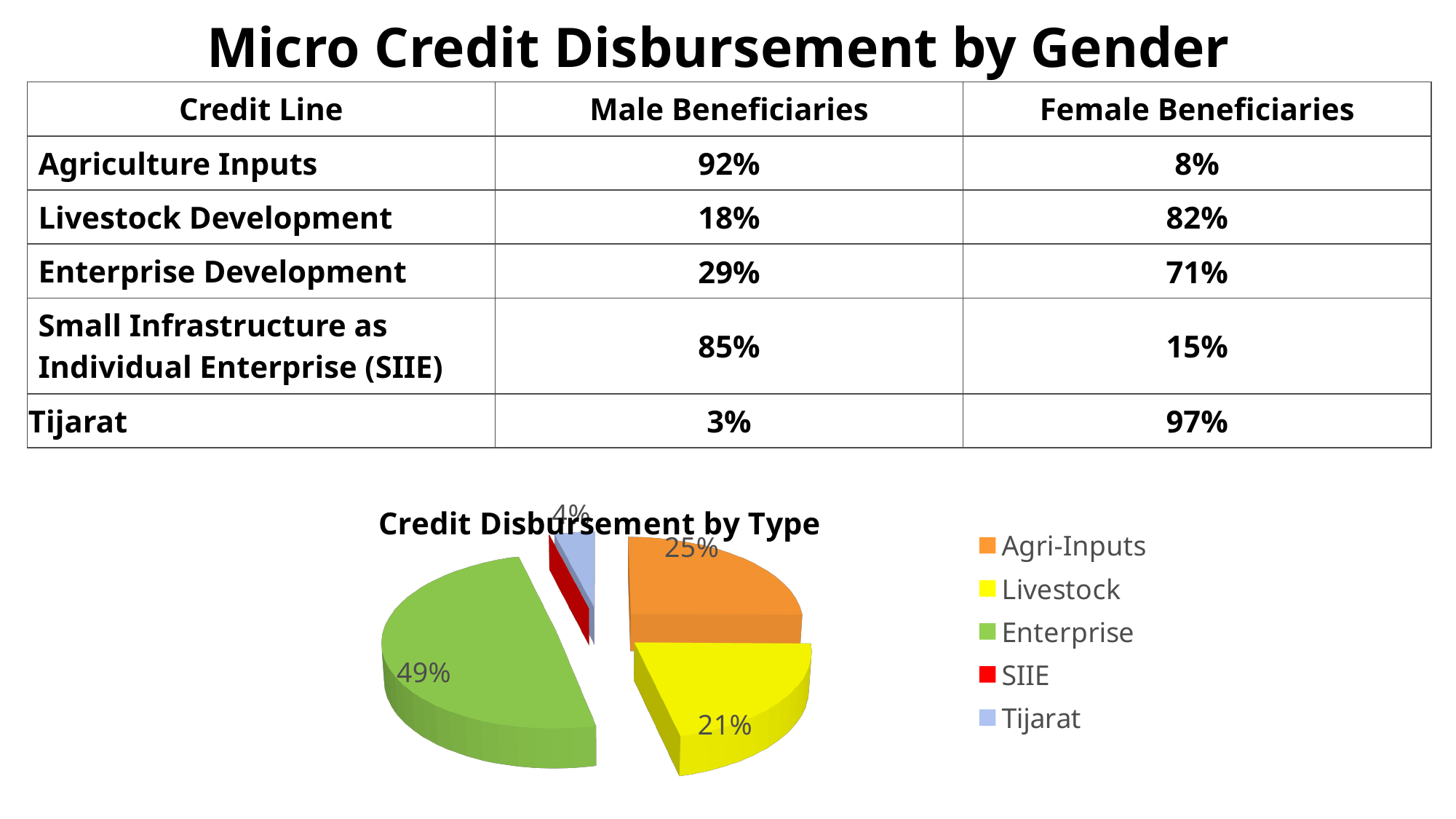
What is the title of the pie chart on the slide? Credit Disbursement by Type In the "Credit Disbursement by Type" pie chart, what is the difference between the Enterprise share and the Agri-Inputs share? 24% In the "Credit Disbursement by Type" pie chart, what share does Enterprise have? 49% How many categories does the legend of the "Credit Disbursement by Type" pie chart list? 5 In the "Credit Disbursement by Type" pie chart, what share does Tijarat have? 4% In the "Credit Disbursement by Type" pie chart, which is larger: Agri-Inputs or Livestock? Agri-Inputs In the "Credit Disbursement by Type" pie chart, what share does Agri-Inputs have? 25% Which category has the smallest slice in the "Credit Disbursement by Type" pie chart? SIIE In the "Credit Disbursement by Type" pie chart, what share does Livestock have? 21% What type of chart is "Credit Disbursement by Type"? pie chart Which category has the largest slice in the "Credit Disbursement by Type" pie chart? Enterprise What colour is the Enterprise slice in the "Credit Disbursement by Type" pie chart? green